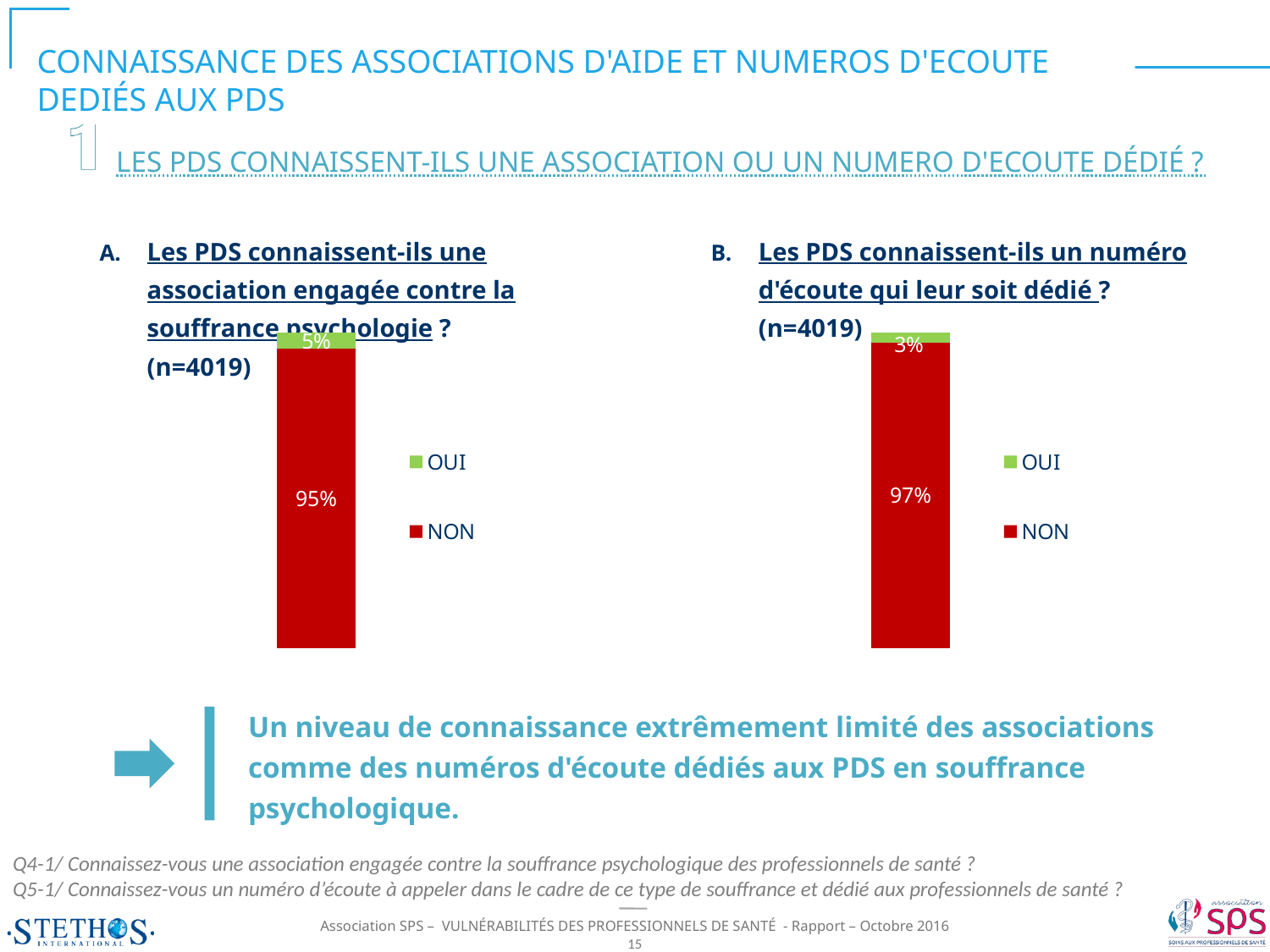
In the left chart (A), what is the difference between the NON and OUI percentages? 90% How many series does the legend of the left chart (A) list? 2 In the right chart (B), what percentage of PDS answered OUI? 3% What type of chart is used in the right chart (B)? Stacked bar chart In the right chart (B), what is the difference between the NON and OUI percentages? 94% Which chart shows the higher OUI percentage, the left chart (A) or the right chart (B)? The left chart (A) In the right chart (B), which colour represents the NON response? Red In the right chart (B, numéro d'écoute dédié), what percentage of PDS answered NON? 97% In the left chart (A, association engagée contre la souffrance psychologique), what percentage of PDS answered NON? 95% In the right chart (B), which response has the smallest share? OUI In the left chart (A), which response has the larger share, OUI or NON? NON In the left chart (A), what percentage of PDS answered OUI? 5%